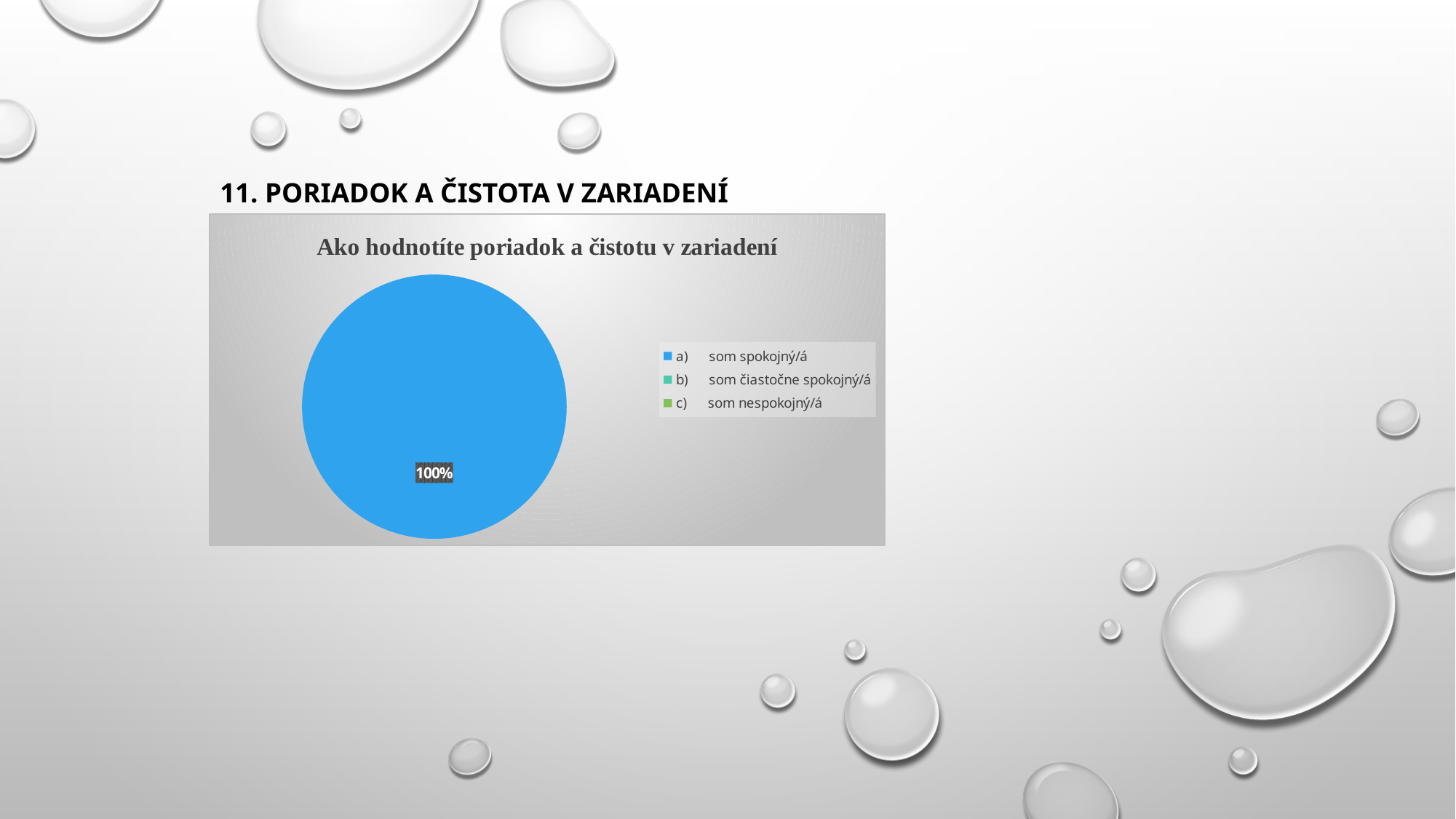
What value is printed as the data label on the pie chart? 100% How many entries does the chart legend list? 3 What kind of chart is shown on the slide? pie chart Which category has the largest share of the pie? a) som spokojný/á What share of the pie does the slice for "a) som spokojný/á" take? 100% Is the share for "a) som spokojný/á" larger or smaller than the share for "c) som nespokojný/á"? larger How many slices are visible in the pie chart? 1 What is the title of the chart? Ako hodnotíte poriadok a čistotu v zariadení Which legend entry is shown in blue? a) som spokojný/á